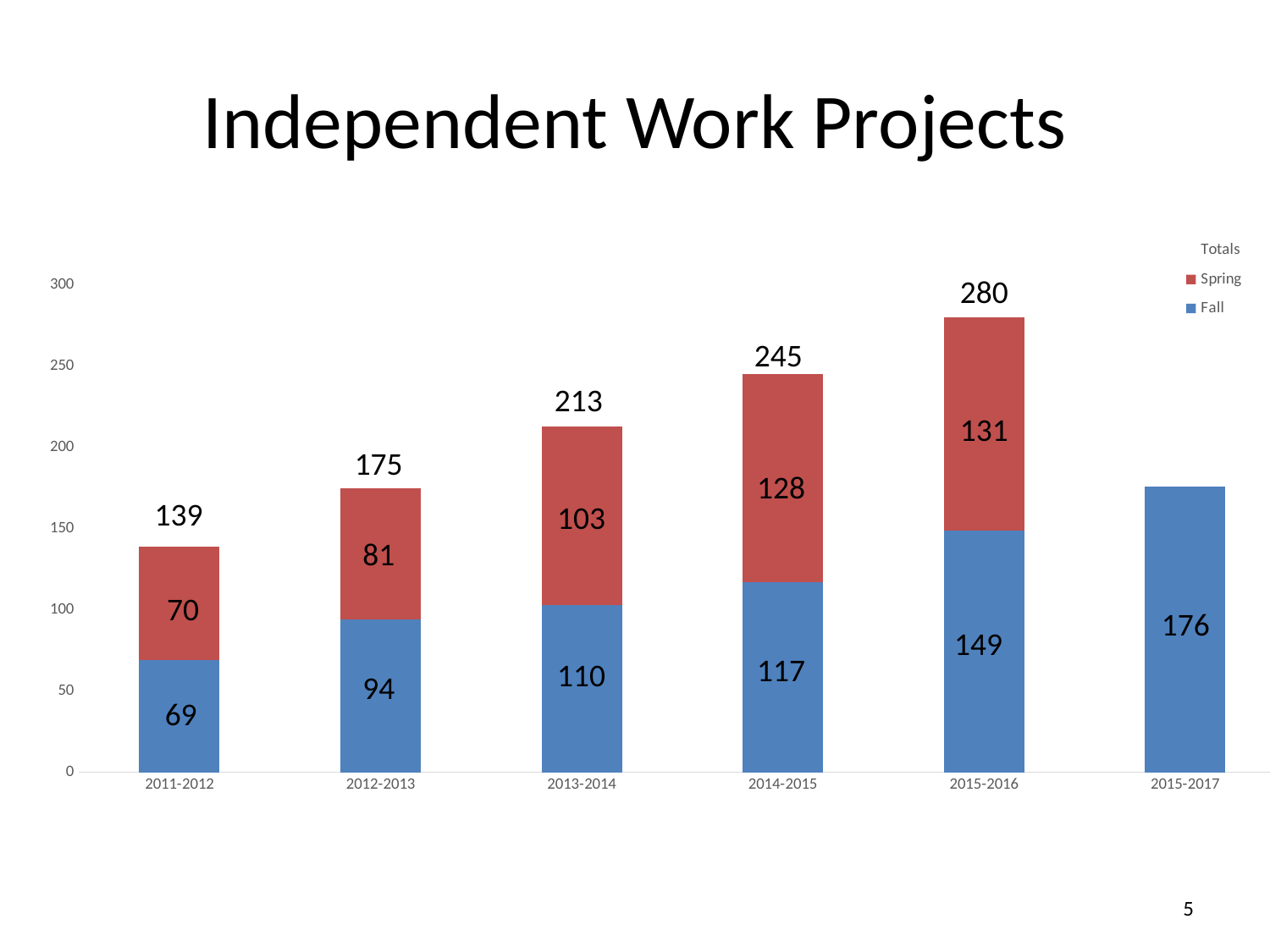
Which year has the highest Fall value? 2015-2017 Which is larger, the Fall value for 2014-2015 or the Spring value for 2014-2015? Spring (128) What is the Fall value for 2011-2012? 69 What is the Spring value for 2014-2015? 128 How many year categories are shown on the x axis? 6 Which year has the lowest Spring value? 2011-2012 How many series does the legend list? 3 What kind of chart is shown? Stacked bar chart Is the total for 2015-2016 greater or less than 250? greater Do the totals rise or fall from 2011-2012 to 2015-2016? Rise What is the total shown above the 2013-2014 bar? 213 What is the difference between the Spring values for 2015-2016 and 2012-2013? 50